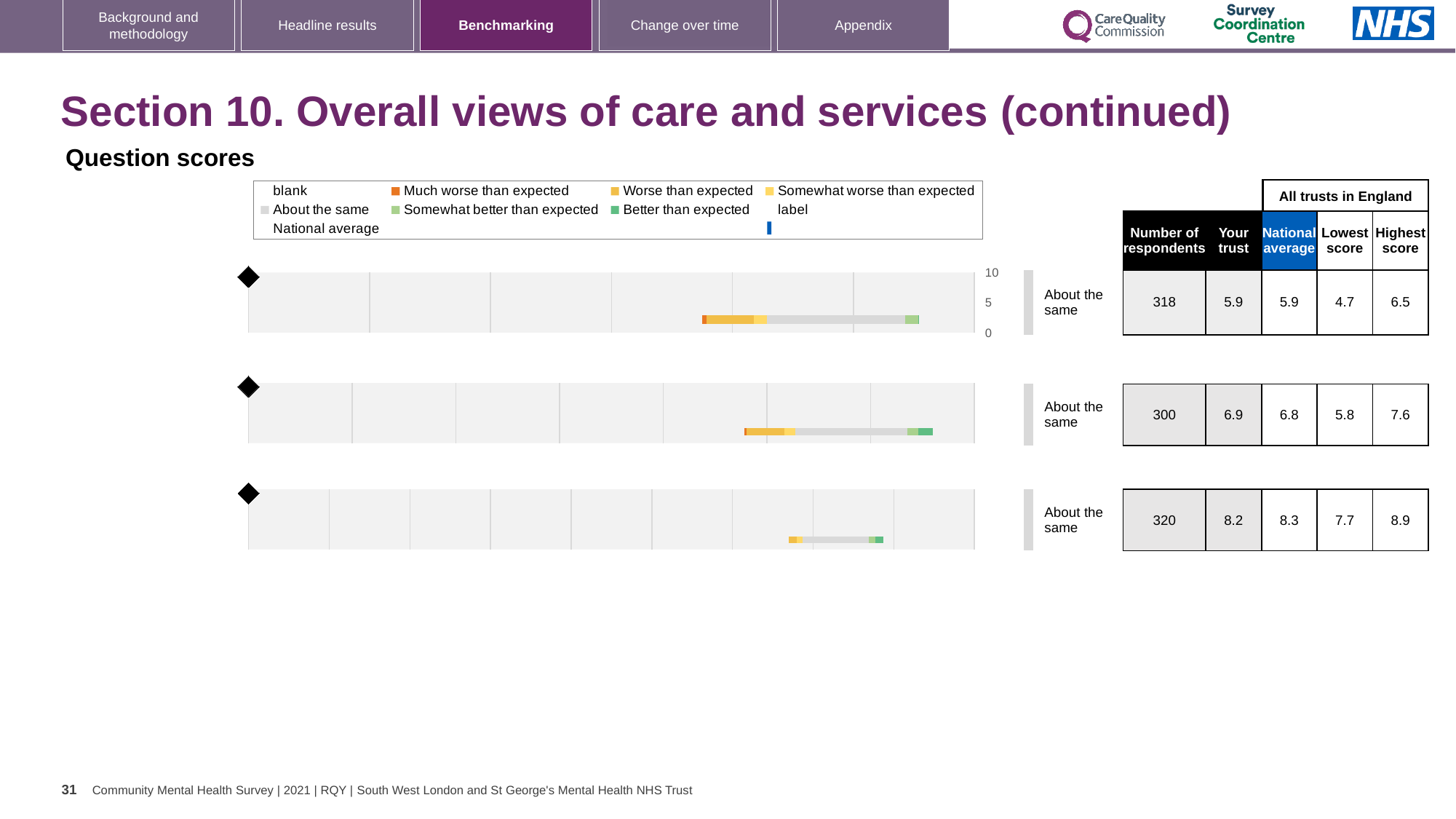
For the bottom chart row, what is the difference between the highest score and the lowest score? 1.2 What is the maximum value shown on the score axis of the top chart? 10 What benchmark category is given for the bottom chart row? About the same For the top chart row, what is the 'Your trust' score? 5.9 For the top chart row, what is the number of respondents shown in the table? 318 Which chart row has the highest 'Your trust' score? the bottom row (8.2) How many question score charts are shown on the slide? 3 For the bottom chart row, what is the highest score among all trusts in England? 8.9 In the legend, which colour represents 'Much worse than expected'? orange What kind of chart is used for the question scores on this slide? bar chart For the middle chart row, what is the national average score? 6.8 For the middle chart row, is the 'Your trust' score or the national average higher? Your trust